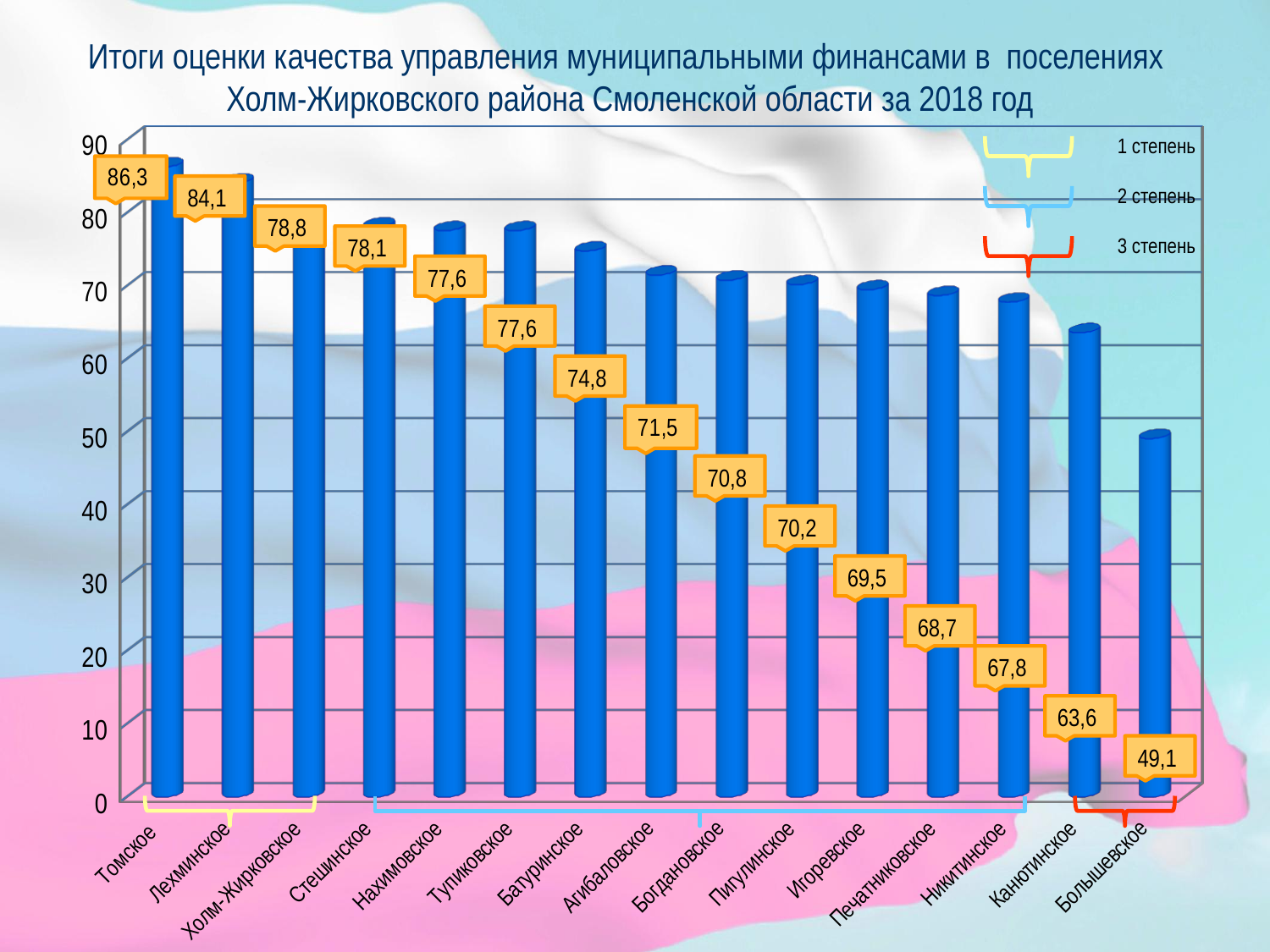
What is the difference between the values for Канютинское and Большевское? 14,5 Which settlement has the lowest value? Большевское What is the value for Канютинское? 63,6 How many settlements are shown on the chart? 15 Which settlement has the highest value? Томское Which is larger, the value for Агибаловское or the value for Игоревское? Агибаловское What is the value for Большевское? 49,1 Do the values rise or fall from left to right along the x axis? fall What kind of chart is shown on the slide? bar chart What is the difference between the values for Томское and Лехминское? 2,2 What is the value for Томское? 86,3 What is the value for Батуринское? 74,8